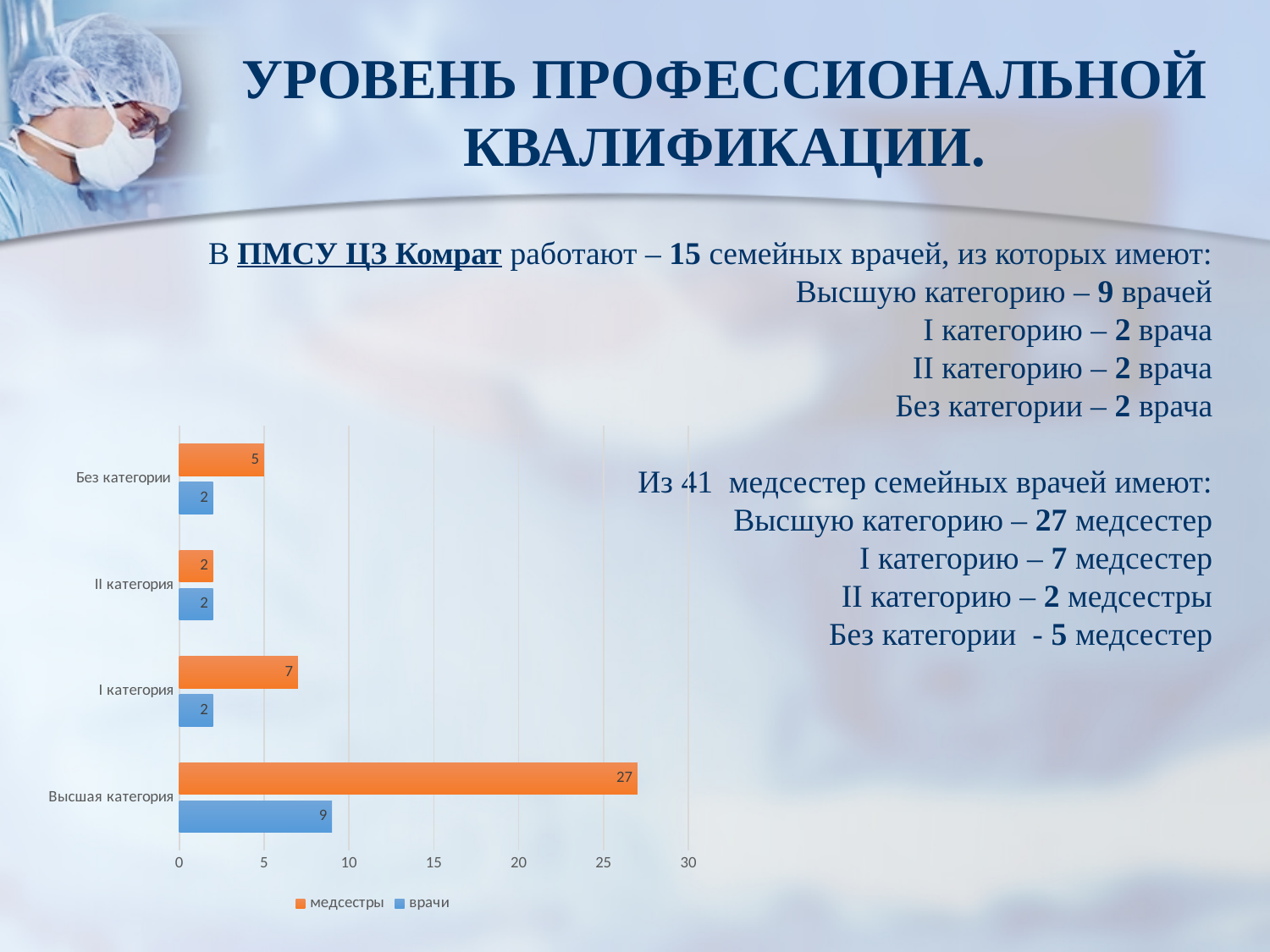
What is the value for медсестры in the Без категории category? 5 Which series is shown in orange in the chart? медсестры How many categories are shown on the chart? 4 Which category has the lowest value for медсестры? II категория What is the value for медсестры in the Высшая категория category? 27 What is the difference between медсестры and врачи in the Высшая категория category? 18 Which is larger: медсестры in I категория or медсестры in Без категории? медсестры in I категория Which category has the highest value for медсестры? Высшая категория What type of chart is shown on the slide? bar chart What is the value for врачи in the Высшая категория category? 9 What is the value for медсестры in the I категория category? 7 How many series does the chart legend list? 2